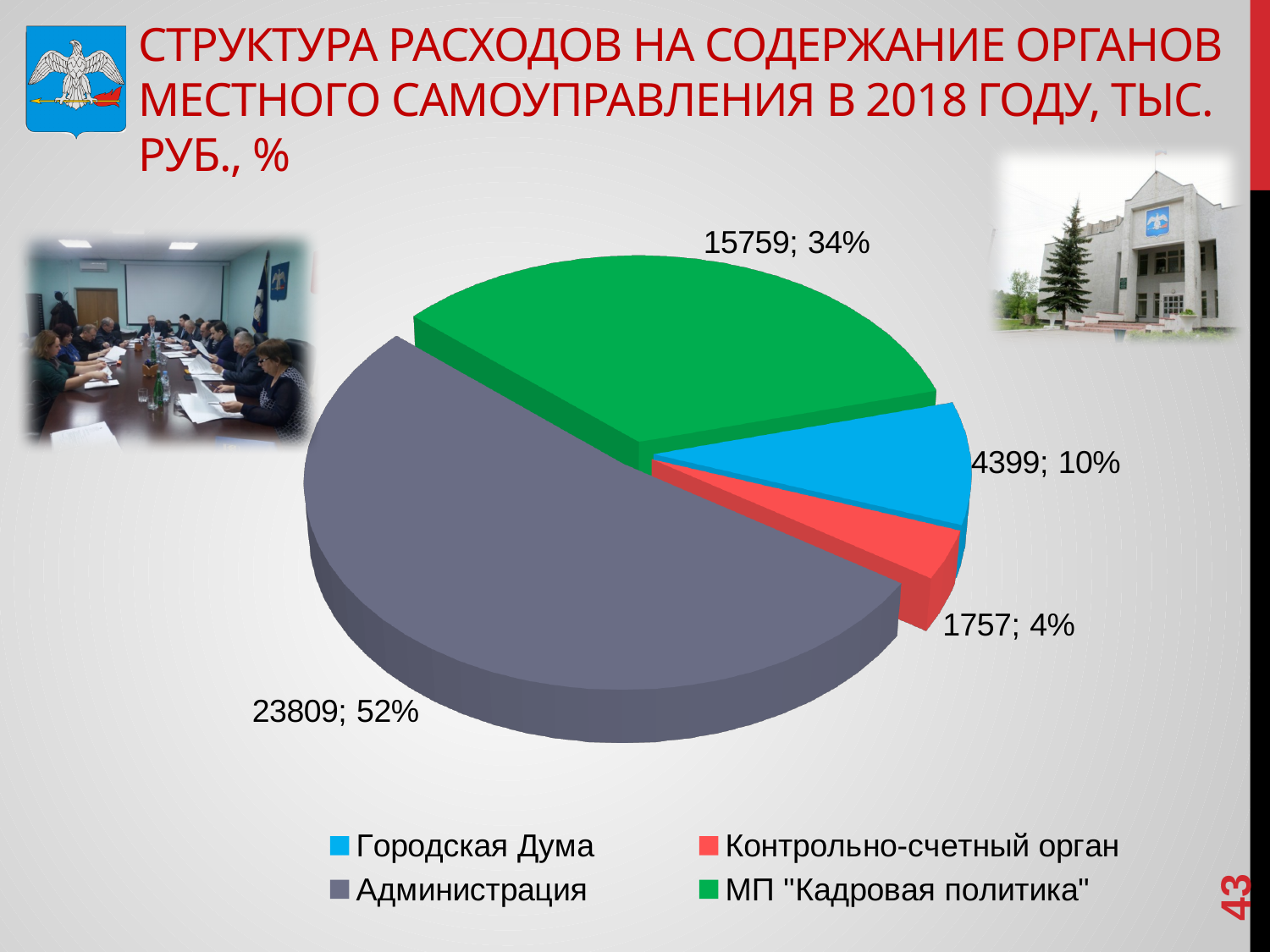
What is the value for Городская Дума? 4399 How many slices does the pie chart have? 4 What kind of chart is shown on the slide? pie chart Which category has the largest slice? Администрация What is the value for Контрольно-счетный орган? 1757 What is the value for МП "Кадровая политика"? 15759 Which category has the smallest slice? Контрольно-счетный орган What is the value for Администрация? 23809 What share of the pie does МП "Кадровая политика" take? 34% What is the difference between the values for Администрация and МП "Кадровая политика"? 8050 What share of the pie does Администрация take? 52% How many entries does the legend list? 4